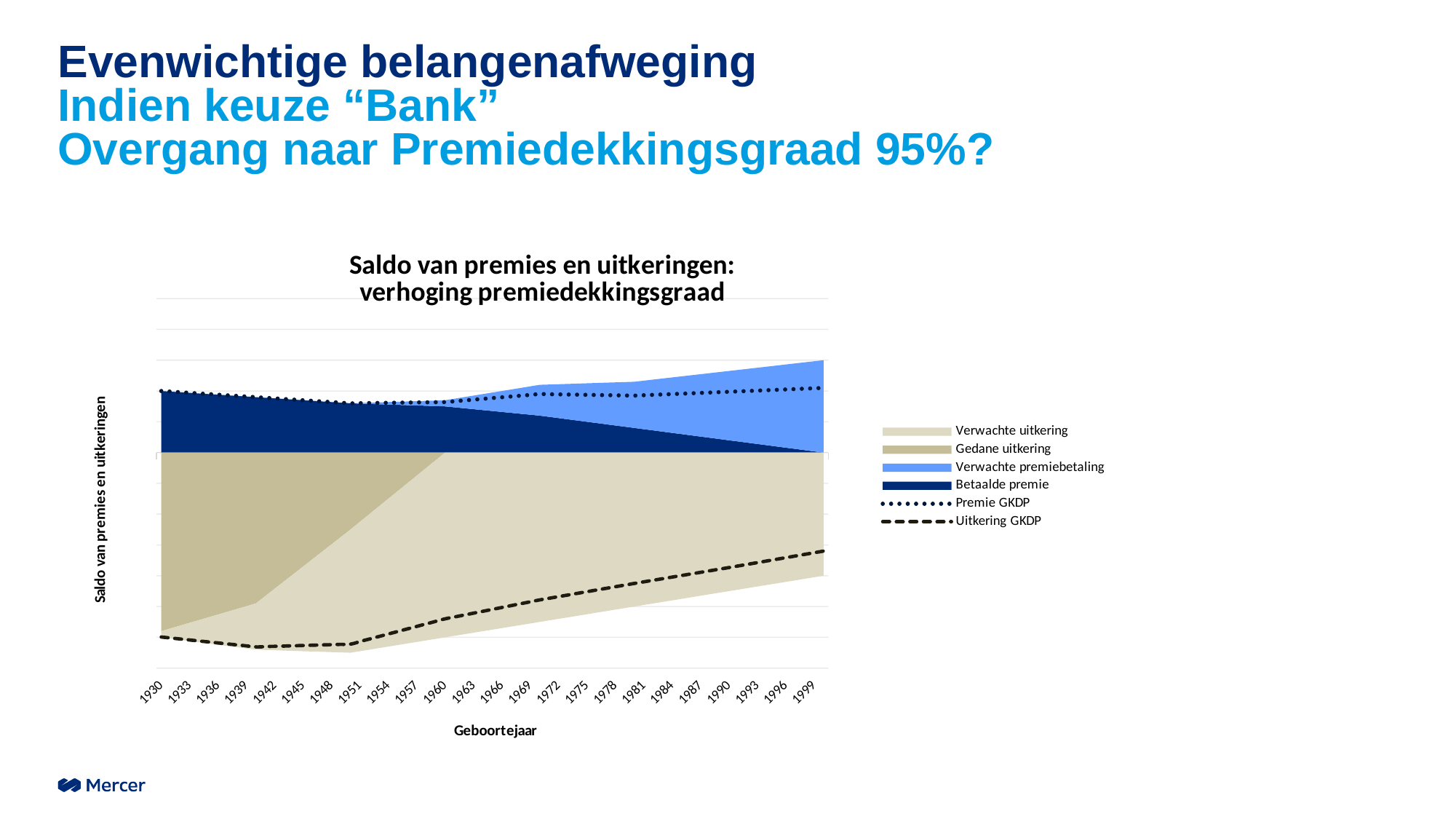
What is the first birth year shown on the x axis of the chart? 1930 Does the Verwachte premiebetaling area grow or shrink from 1960 to 1999? Grow What is the last birth year shown on the x axis of the chart? 1999 How many series does the legend of the chart list? 6 What kind of chart is shown on the slide? Combination area and line chart Does the Uitkering GKDP dashed line rise or fall from 1951 to 1999? Rise How many birth years are labelled along the x axis of the chart? 24 Does the Gedane uitkering area grow or shrink from 1930 to 1960? Shrink What is the label of the x axis of the chart? Geboortejaar Which legend entry is drawn as a dotted line? Premie GKDP What is the title of the chart? Saldo van premies en uitkeringen: verhoging premiedekkingsgraad